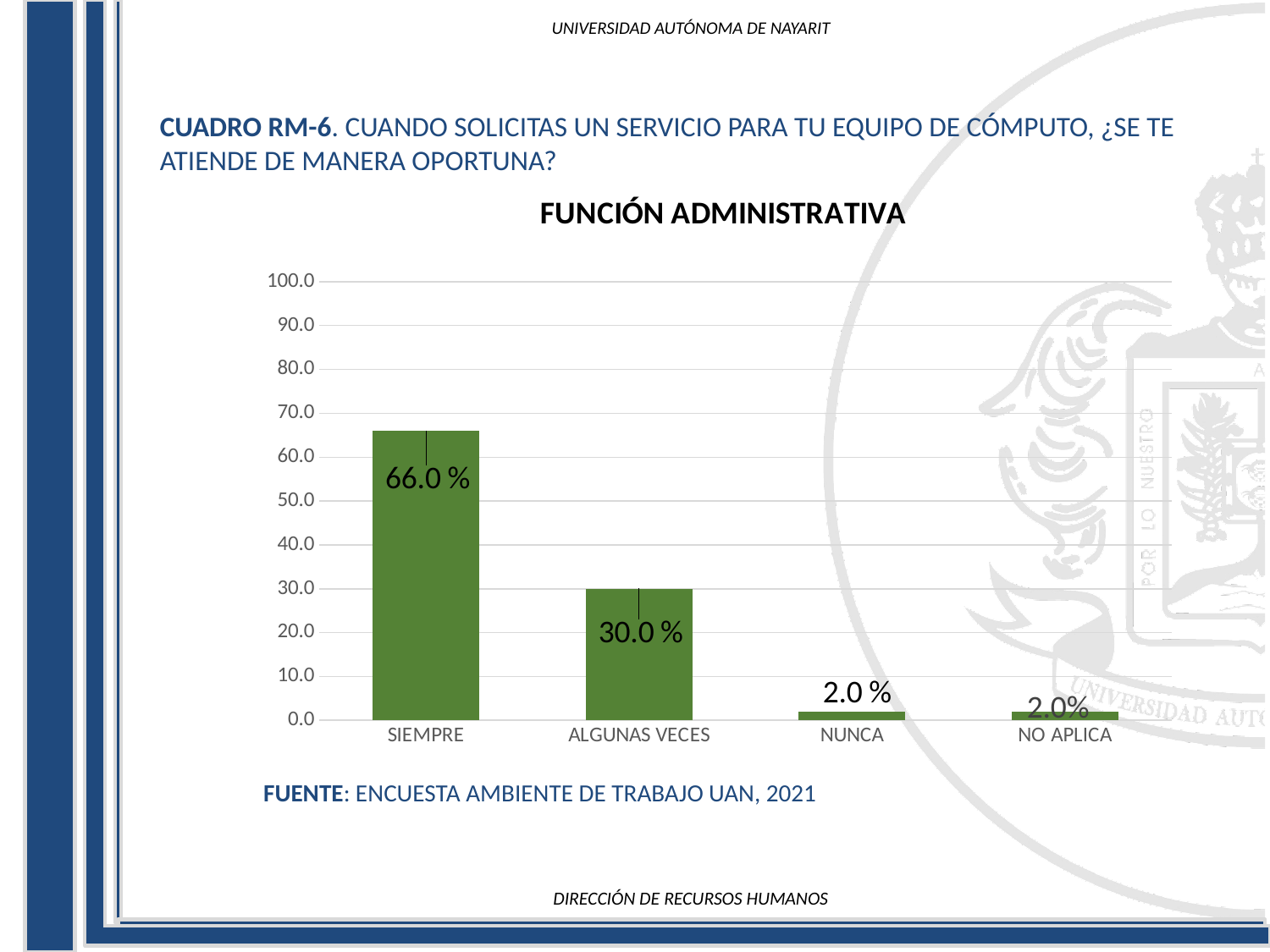
Which category has the highest value? SIEMPRE What is the value for NUNCA? 2.0 % Is the value for SIEMPRE greater or less than 60.0? greater What is the difference between the values for SIEMPRE and ALGUNAS VECES? 36.0 % Which is larger, the value for ALGUNAS VECES or the value for NUNCA? ALGUNAS VECES What is the value for ALGUNAS VECES? 30.0 % How many categories are shown on the x axis? 4 What is the value for NO APLICA? 2.0% What kind of chart is shown on the slide? bar chart What is the title of the chart? FUNCIÓN ADMINISTRATIVA What colour are the bars in the chart? green What is the value for SIEMPRE? 66.0 %